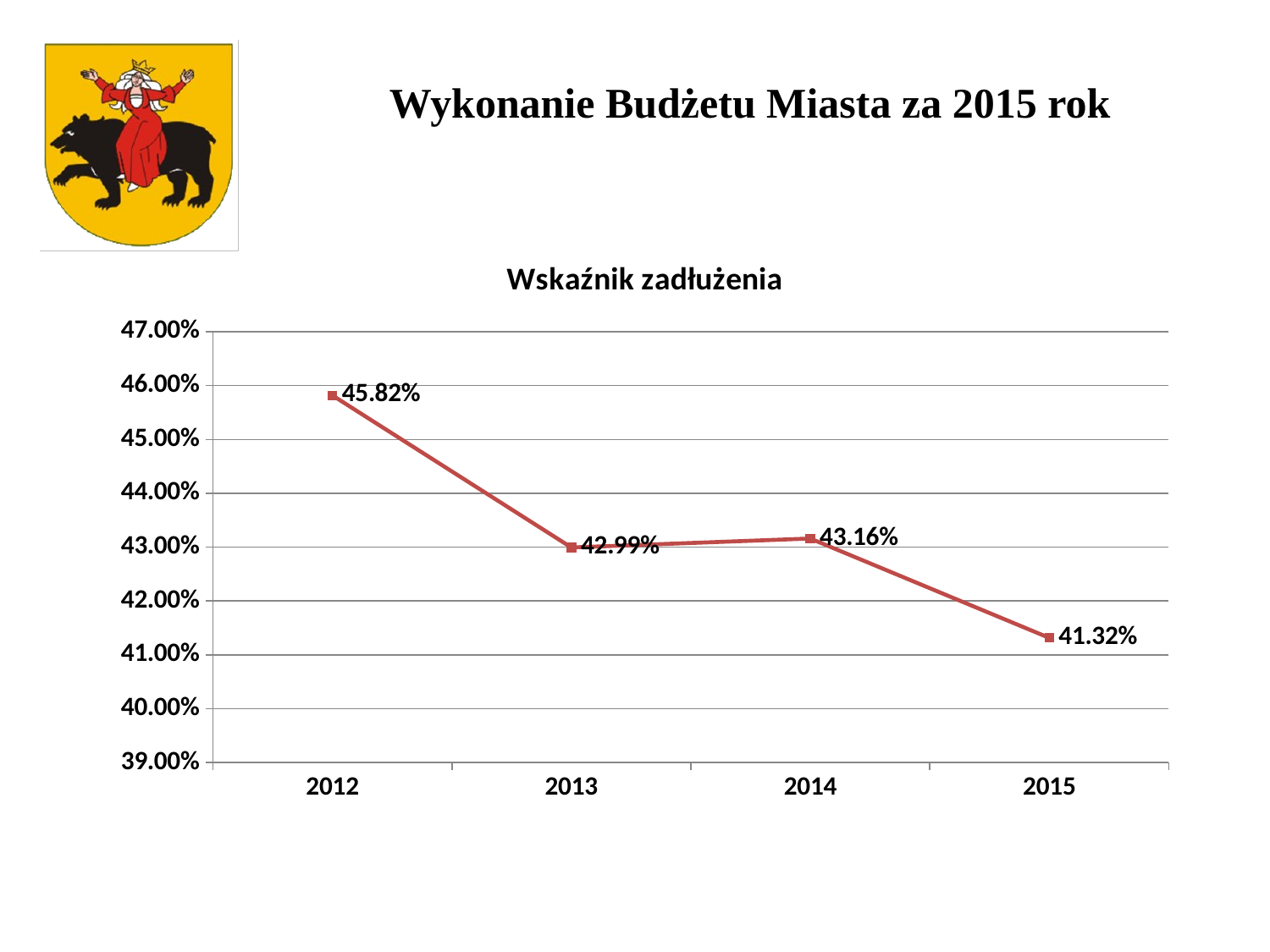
Which year has the highest value? 2012 Is the value for 2015 greater or less than 42.00%? less What is the value for 2015? 41.32% What is the value for 2014? 43.16% Which year has the lowest value? 2015 What kind of chart is shown? line chart Which is larger, the value for 2013 or the value for 2014? 2014 What is the value for 2013? 42.99% What is the value for 2012? 45.82% How many years are plotted on the chart? 4 What is the difference between the values for 2014 and 2013? 0.17% What is the difference between the values for 2012 and 2015? 4.50%